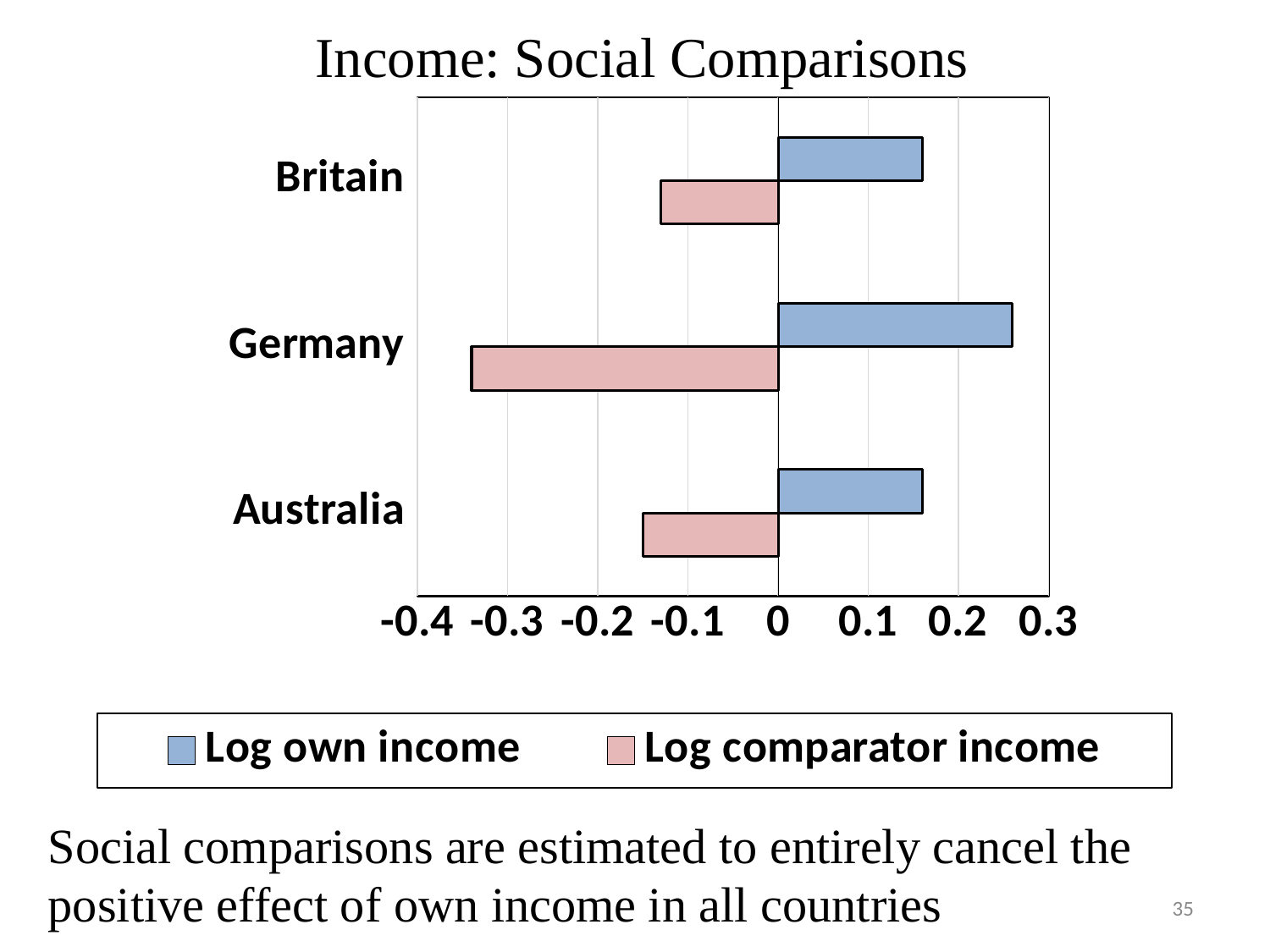
Which country has the lowest value for Log comparator income? Germany What is the title of the chart? Income: Social Comparisons Is the Log own income value for Germany greater or less than 0.2? greater Is the Log comparator income value for Germany greater or less than -0.3? less What kind of chart is shown on the slide? Bar chart How many series does the legend list? 2 How many countries are shown on the chart? 3 Which series is shown in blue? Log own income Which is larger: the Log own income value for Germany or for Britain? Germany Which country has the highest value for Log own income? Germany Is the Log comparator income value for Australia greater or less than -0.2? greater